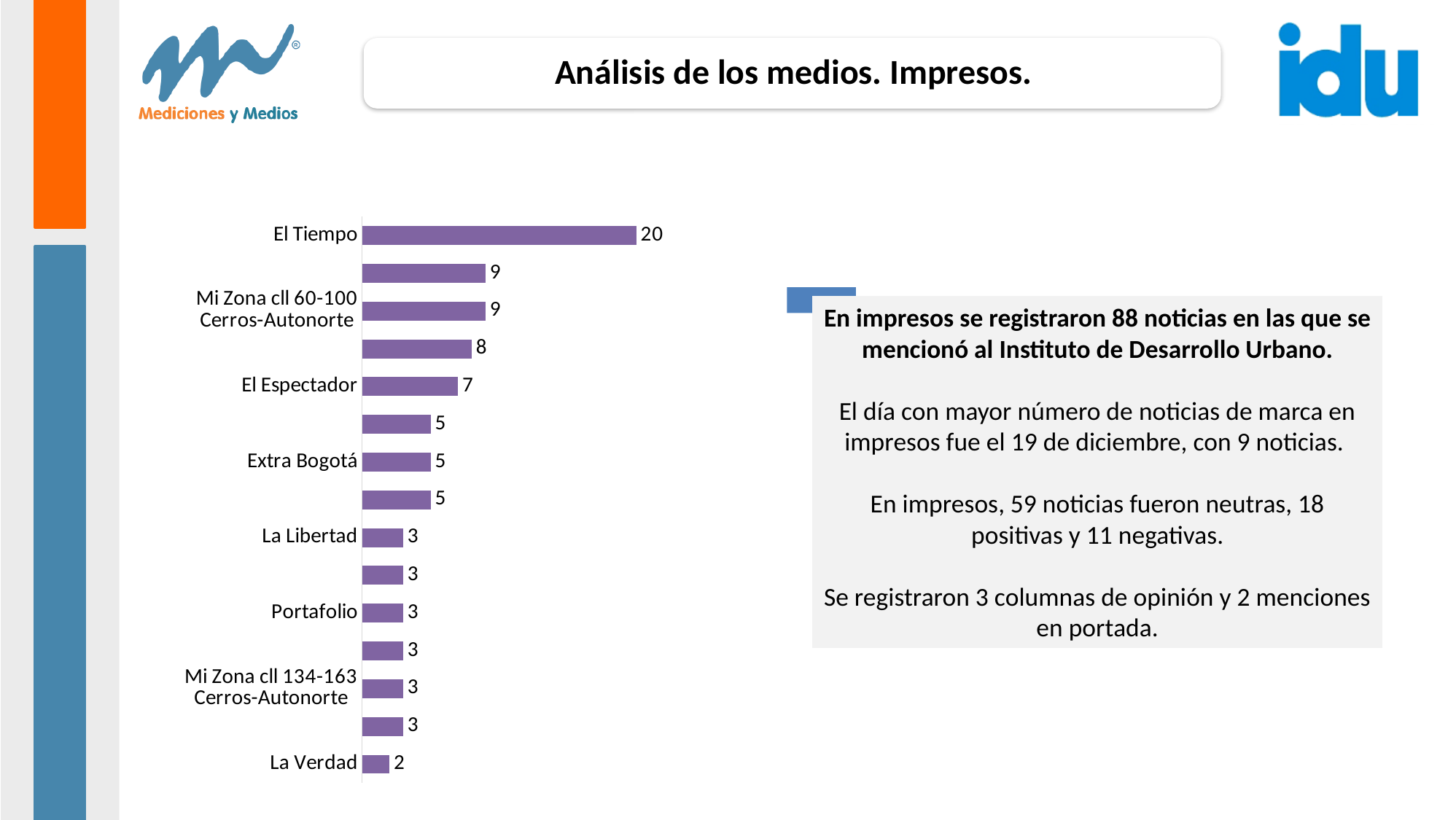
What value is shown for El Espectador? 7 What value is shown for La Verdad? 2 What value is shown for Mi Zona cll 134-163 Cerros-Autonorte? 3 What is the difference between the values for El Tiempo and El Espectador? 13 What value is shown for El Tiempo? 20 Which has a larger value, El Espectador or Extra Bogotá? El Espectador Which category has the highest value in the chart? El Tiempo What value is shown for Mi Zona cll 60-100 Cerros-Autonorte? 9 How many bars are plotted in the chart? 15 What kind of chart is shown on the slide? Bar chart What value is shown for Extra Bogotá? 5 Which category has the lowest value in the chart? La Verdad